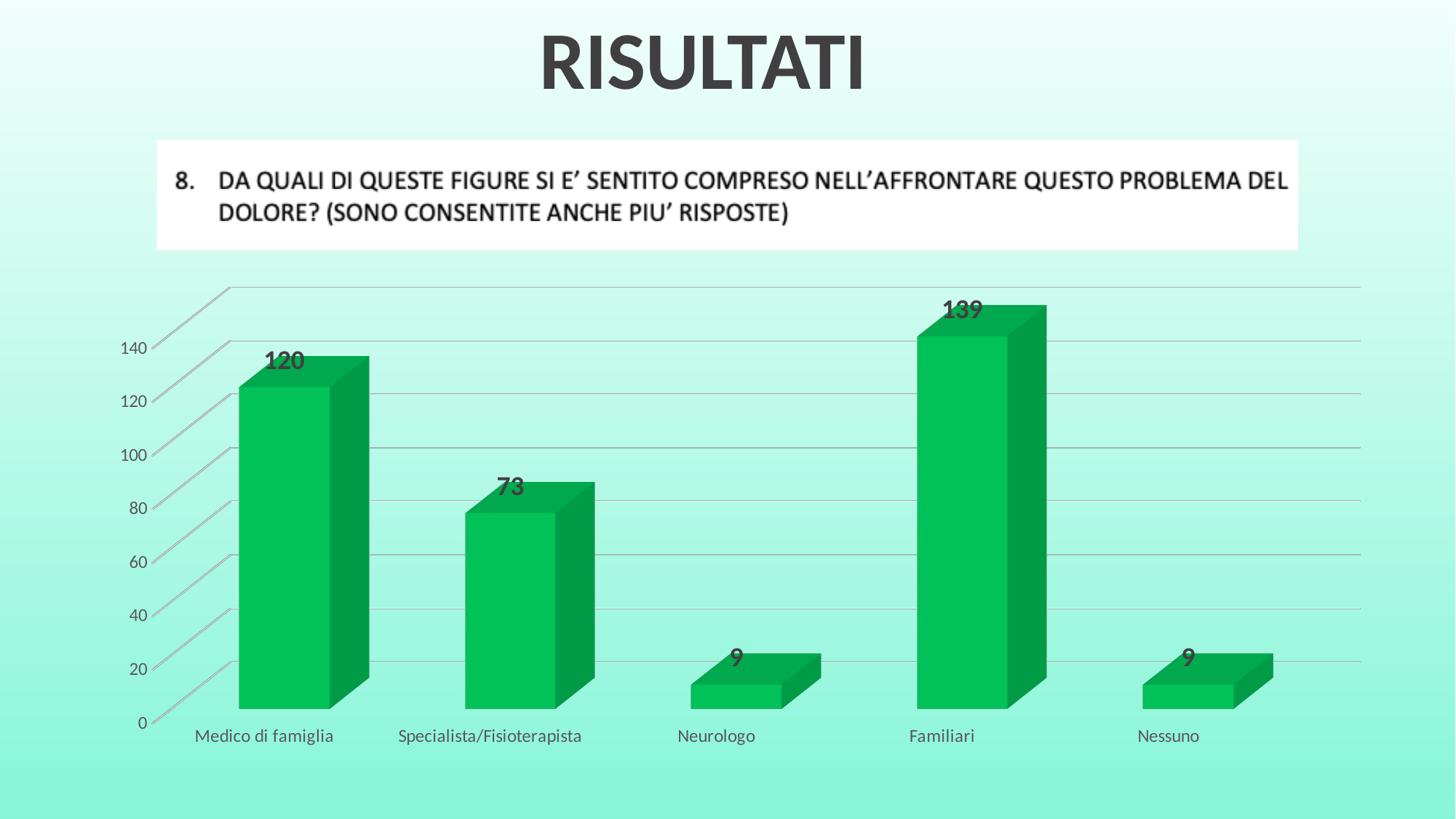
What is the difference between the values for Medico di famiglia and Specialista/Fisioterapista? 47 What kind of chart is shown on the slide? bar chart What is the value for Neurologo? 9 What is the value for Familiari? 139 How many categories are shown on the x axis? 5 Which category has the highest value? Familiari Is the value for Specialista/Fisioterapista greater or less than 100? less Which is larger, the value for Specialista/Fisioterapista or the value for Nessuno? Specialista/Fisioterapista What is the value for Medico di famiglia? 120 What is the difference between the values for Familiari and Medico di famiglia? 19 What is the value for Specialista/Fisioterapista? 73 What colour are the bars in the chart? green